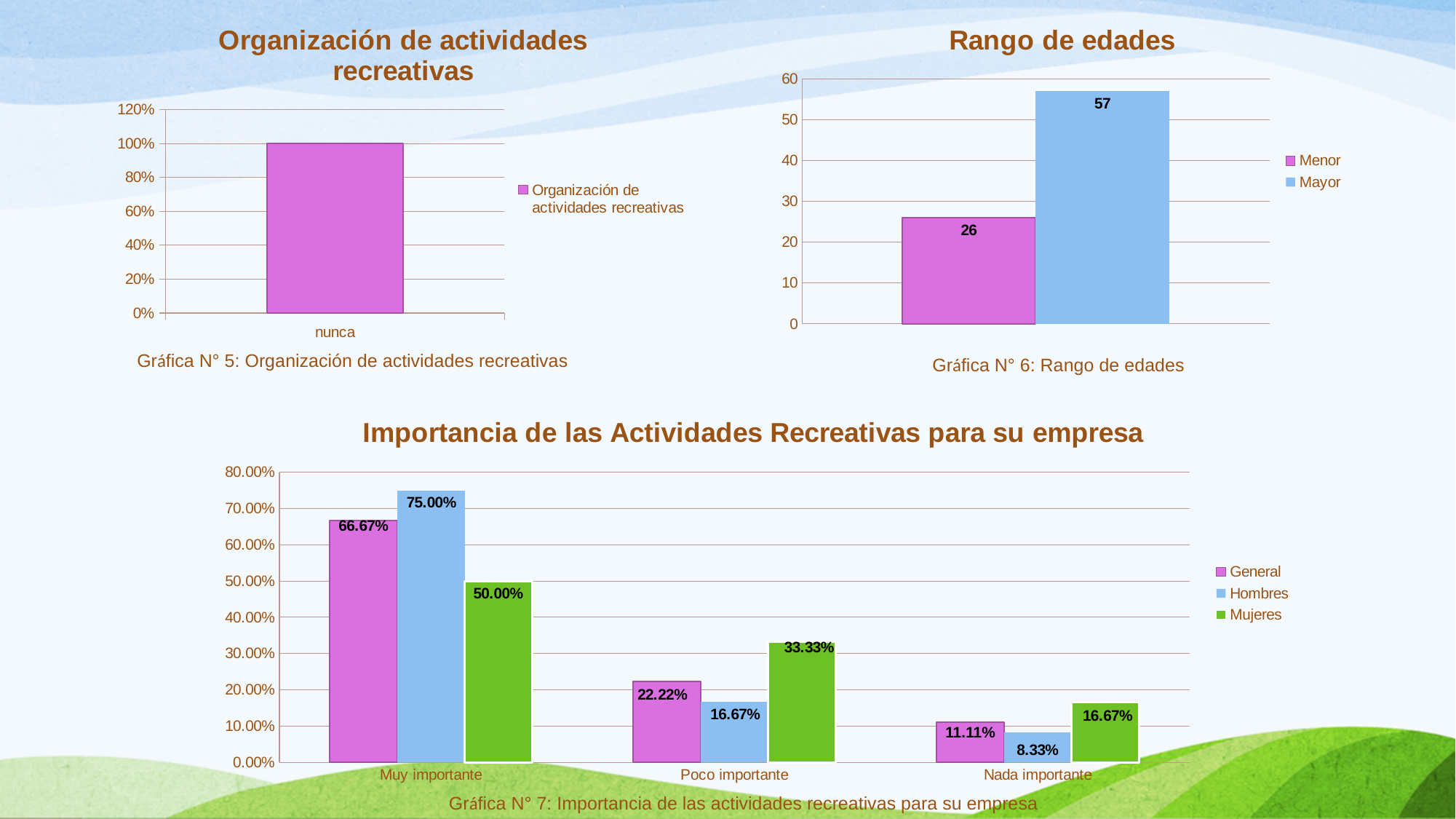
In the chart titled 'Importancia de las Actividades Recreativas para su empresa', which series has the lowest value in the 'Nada importante' category? Hombres In the chart titled 'Organización de actividades recreativas', what is the value for 'nunca'? 100% In the chart titled 'Rango de edades', what is the value for Mayor? 57 In the chart titled 'Importancia de las Actividades Recreativas para su empresa', what is the value for Hombres in the 'Muy importante' category? 75.00% In the chart titled 'Rango de edades', which is larger, Menor or Mayor? Mayor In the chart titled 'Importancia de las Actividades Recreativas para su empresa', do the General values rise or fall from 'Muy importante' to 'Nada importante'? fall In the chart titled 'Rango de edades', what is the difference between the Mayor and Menor values? 31 In the chart titled 'Importancia de las Actividades Recreativas para su empresa', what is the value for Mujeres in the 'Poco importante' category? 33.33% In the chart titled 'Importancia de las Actividades Recreativas para su empresa', how many series does the legend list? 3 In the chart titled 'Importancia de las Actividades Recreativas para su empresa', what is the difference between the General values for 'Muy importante' and 'Poco importante'? 44.45% In the chart titled 'Organización de actividades recreativas', how many categories are shown on the x axis? 1 What kind of chart is the one titled 'Rango de edades'? bar chart